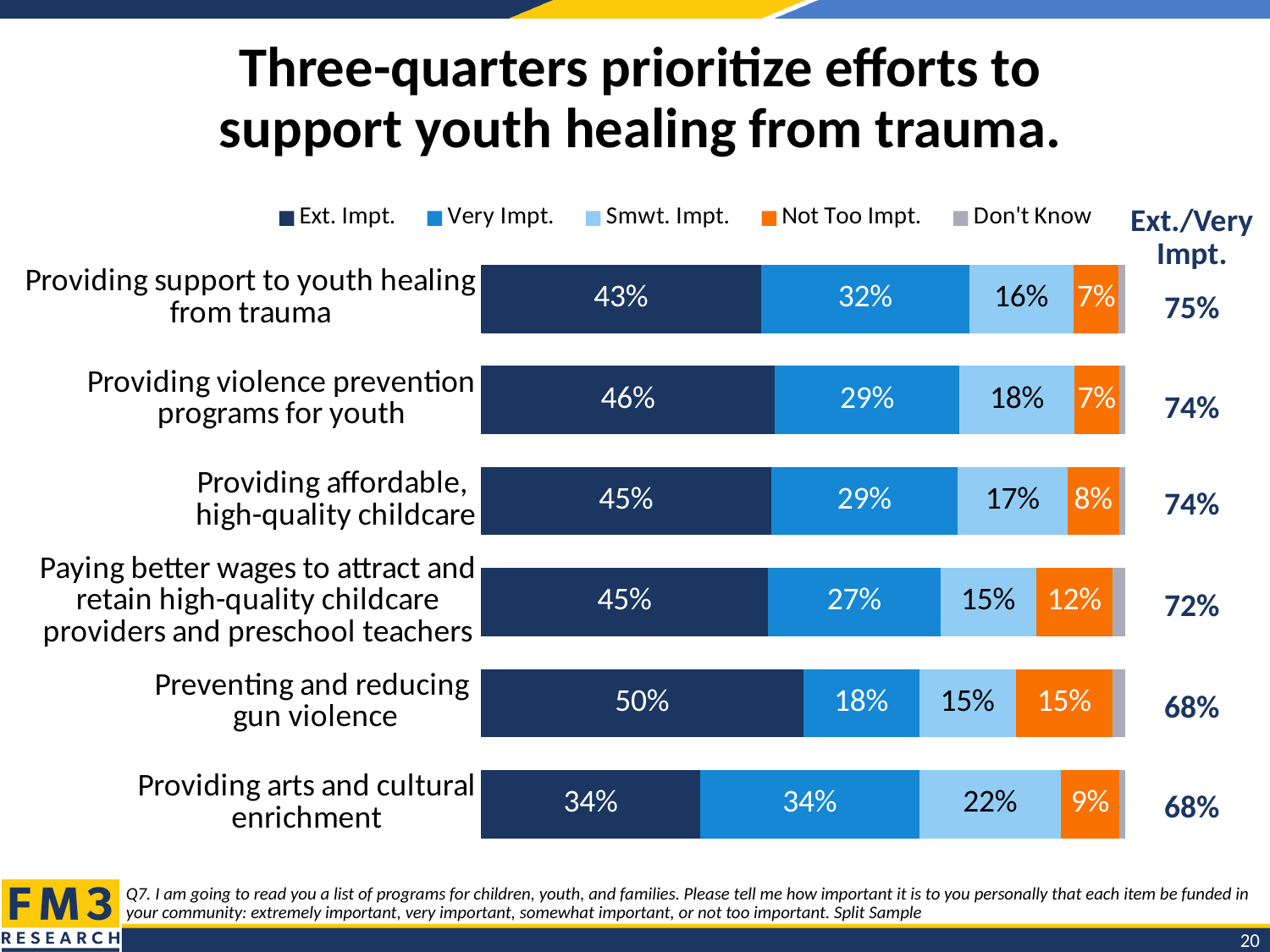
What is the Very Impt. value for "Providing arts and cultural enrichment"? 34% What percentage rated "Preventing and reducing gun violence" as Ext. Impt.? 50% What kind of chart is shown on the slide? Stacked bar chart What is the Not Too Impt. value for "Paying better wages to attract and retain high-quality childcare providers and preschool teachers"? 12% Which item has the lowest Ext. Impt. percentage? Providing arts and cultural enrichment What is the Ext./Very Impt. combined figure shown for "Providing support to youth healing from trauma"? 75% How many series does the legend list? 5 Which item has the highest Ext. Impt. percentage? Preventing and reducing gun violence Which has a larger Very Impt. share: "Providing support to youth healing from trauma" or "Providing violence prevention programs for youth"? Providing support to youth healing from trauma What is the difference in Ext. Impt. percentage between "Providing violence prevention programs for youth" and "Providing support to youth healing from trauma"? 3 percentage points How many program items are shown in the chart? 6 What is the title of the slide? Three-quarters prioritize efforts to support youth healing from trauma.